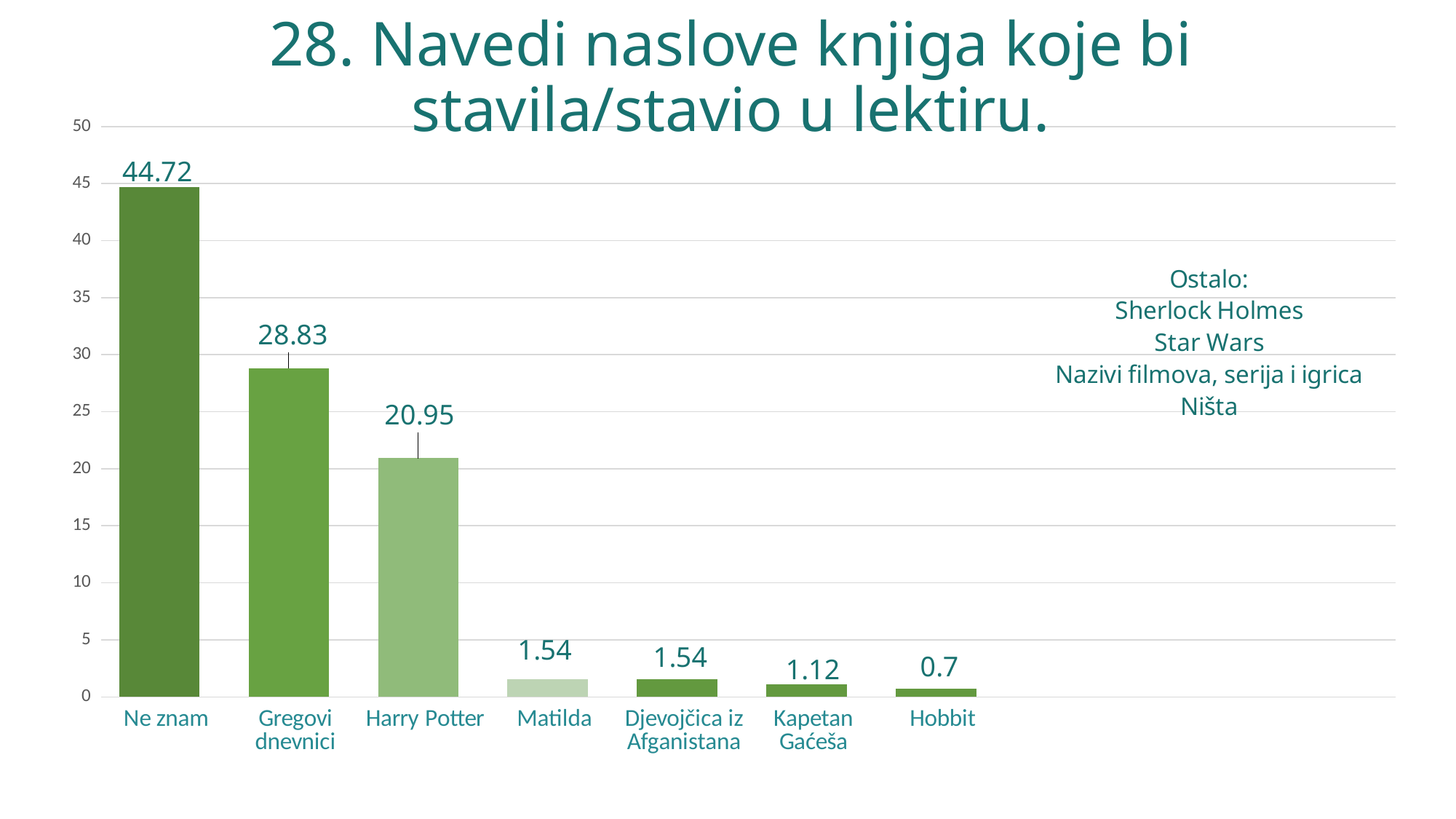
Is the value for Ne znam greater or less than 40? greater What is the value for Gregovi dnevnici? 28.83 How many categories are shown on the chart? 7 What kind of chart is shown on the slide? bar chart Which category has the highest value? Ne znam What is the difference between the values for Ne znam and Gregovi dnevnici? 15.89 Which is larger, the value for Harry Potter or the value for Gregovi dnevnici? Gregovi dnevnici What is the value for Kapetan Gaćeša? 1.12 What is the value for Harry Potter? 20.95 What is the title of the chart? 28. Navedi naslove knjiga koje bi stavila/stavio u lektiru. Which category has the lowest value? Hobbit What is the value for Hobbit? 0.7